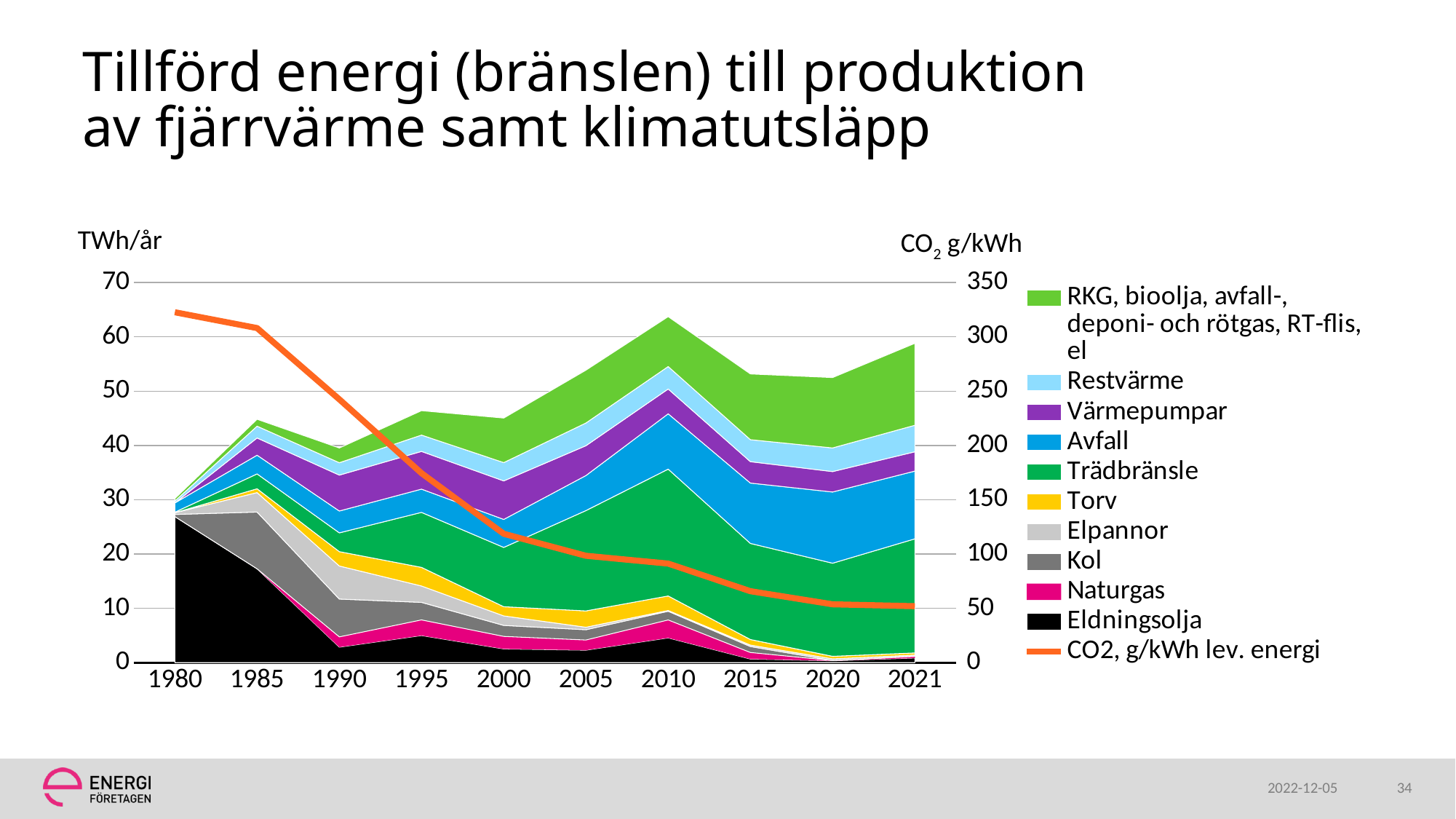
Is the value of the CO2, g/kWh lev. energi line in 1995 greater or less than 200? less How many years are shown along the x axis? 10 Is the total stacked energy in 1980 greater or less than 40 TWh/år? less Is the value of the CO2, g/kWh lev. energi line in 1980 greater or less than 300? greater What unit is shown on the right-hand axis? CO2 g/kWh How many entries does the legend list? 11 Does the CO2, g/kWh lev. energi line rise or fall from 1980 to 2021? Fall In which year is the total stacked energy (TWh/år) lowest? 1980 Which series is shown in black at the bottom of the stack? Eldningsolja What kind of chart is shown on the slide? Stacked area chart with a line